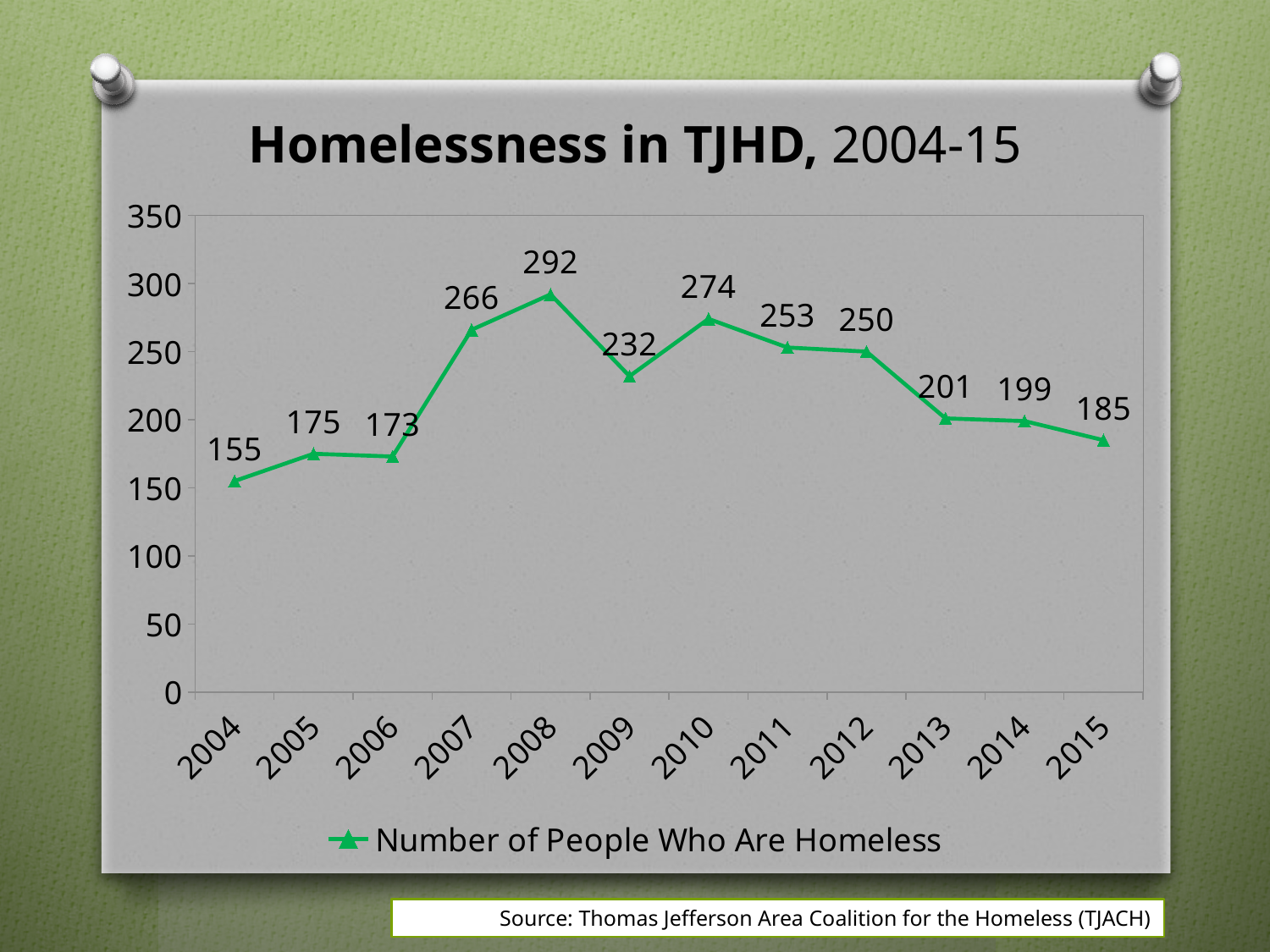
Which year had the highest number of people who are homeless? 2008 How many years are plotted on the chart? 12 What was the number of people who are homeless in 2008? 292 What was the number of people who are homeless in 2004? 155 Did the number of people who are homeless rise or fall from 2012 to 2015? Fall What is the difference between the number of people who are homeless in 2015 and in 2004? 30 What was the number of people who are homeless in 2015? 185 What is the difference between the number of people who are homeless in 2008 and in 2009? 60 How many series does the legend list? 1 Which year had more people who are homeless, 2010 or 2012? 2010 What kind of chart is shown on the slide? Line chart Which year had the lowest number of people who are homeless? 2004